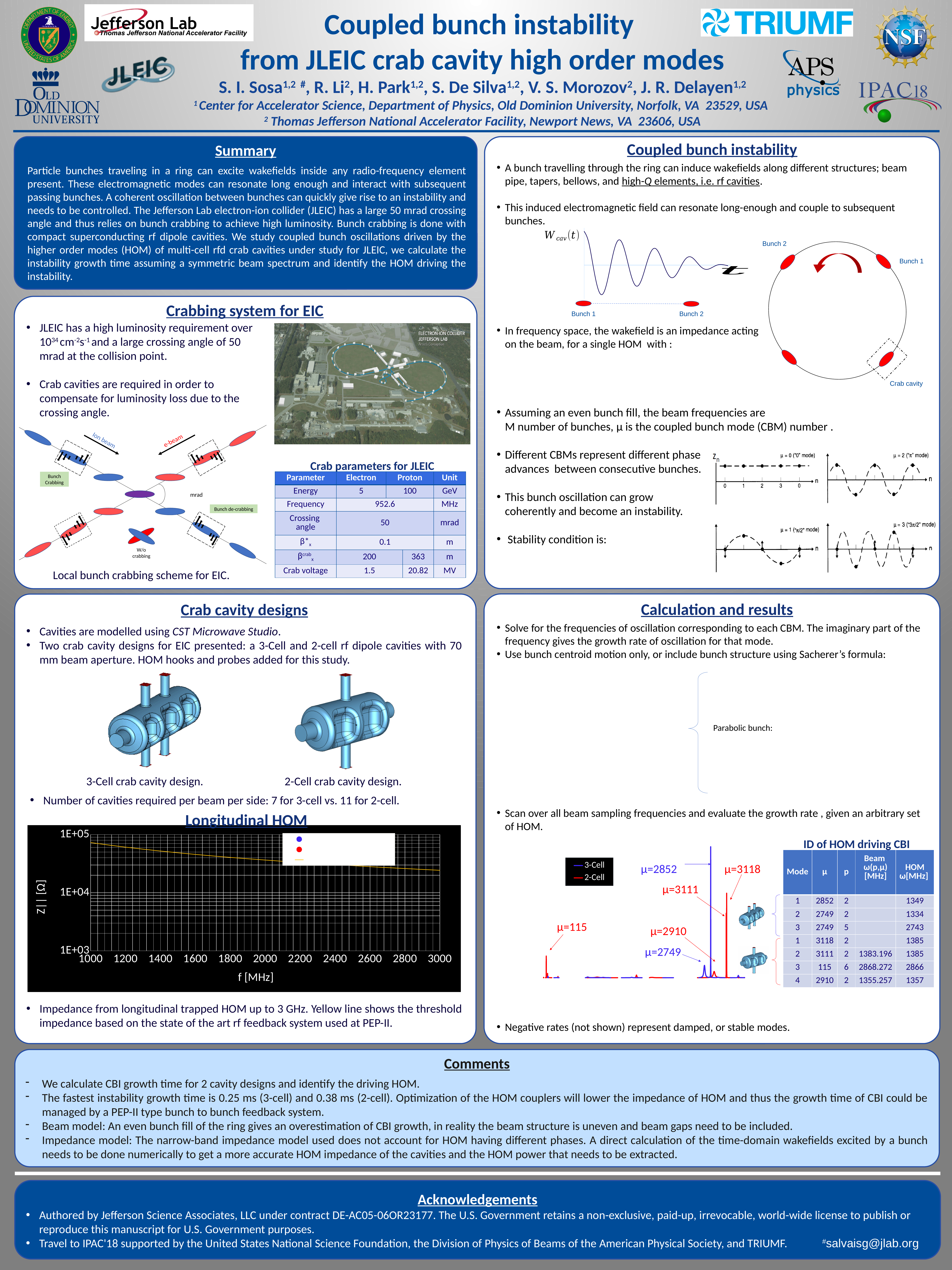
How many series does the legend of the growth rate chart in the Calculation and results section list? 2 In the growth rate chart in the Calculation and results section, is the peak at μ=2852 taller or shorter than the peak at μ=2749? taller What kind of chart is the Longitudinal HOM chart? line chart In the growth rate chart in the Calculation and results section, which labelled mode has the tallest peak? μ=2852 In the Longitudinal HOM chart, is the yellow threshold line at 3000 MHz greater or less than 1E+05 Ω? less In the growth rate chart in the Calculation and results section, which series does the peak labelled μ=3118 belong to? 2-Cell In the Longitudinal HOM chart, is the yellow threshold line at 1000 MHz greater or less than 1E+04 Ω? greater In the Longitudinal HOM chart, does the yellow threshold line rise or fall as frequency increases from 1000 to 3000 MHz? fall In the growth rate chart in the Calculation and results section, which colour represents the 3-Cell cavity? blue In the Longitudinal HOM chart, what is the highest value shown on the y axis? 1E+05 In the Longitudinal HOM chart, what is the label of the y axis? |Z| [Ω]